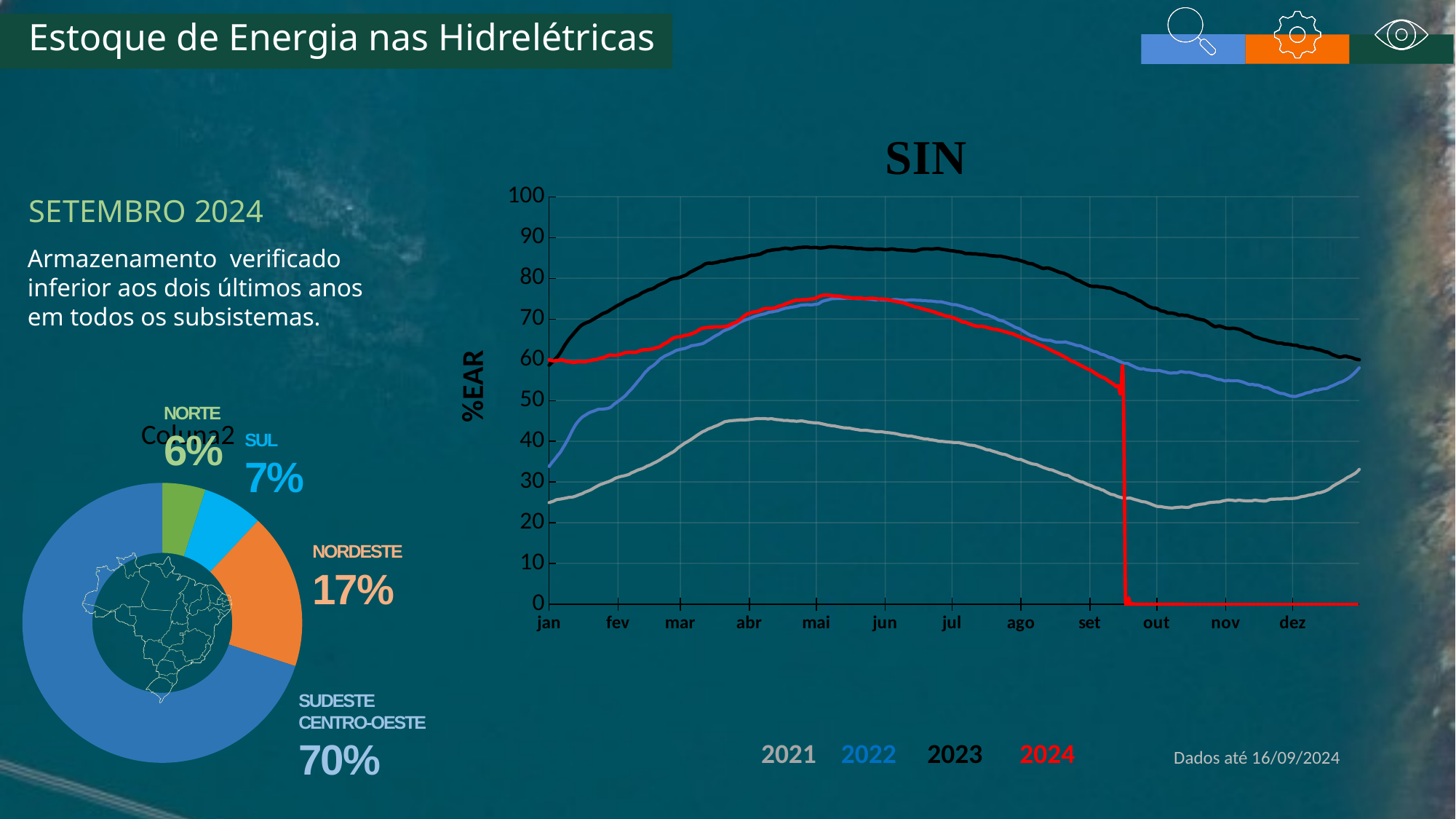
How many series does the legend of the SIN chart list? 4 In the SIN chart, which series has the highest value in jun? 2023 What kind of chart is the SIN chart? line chart In the donut chart on the left, what is the difference in percentage points between SUDESTE CENTRO-OESTE and NORDESTE? 53 In the SIN chart, is the 2021 value in jan greater or less than 30? less In the SIN chart, is the 2023 value in mai greater or less than 80? greater How many regions are shown in the donut chart on the left? 4 In the donut chart on the left, which has a larger share, SUL or NORTE? SUL In the donut chart on the left, what share does NORDESTE have? 17% In the donut chart on the left, which region has the smallest share? NORTE In the donut chart on the left, which region has the largest share? SUDESTE CENTRO-OESTE In the donut chart on the left, what share does SUDESTE CENTRO-OESTE have? 70%